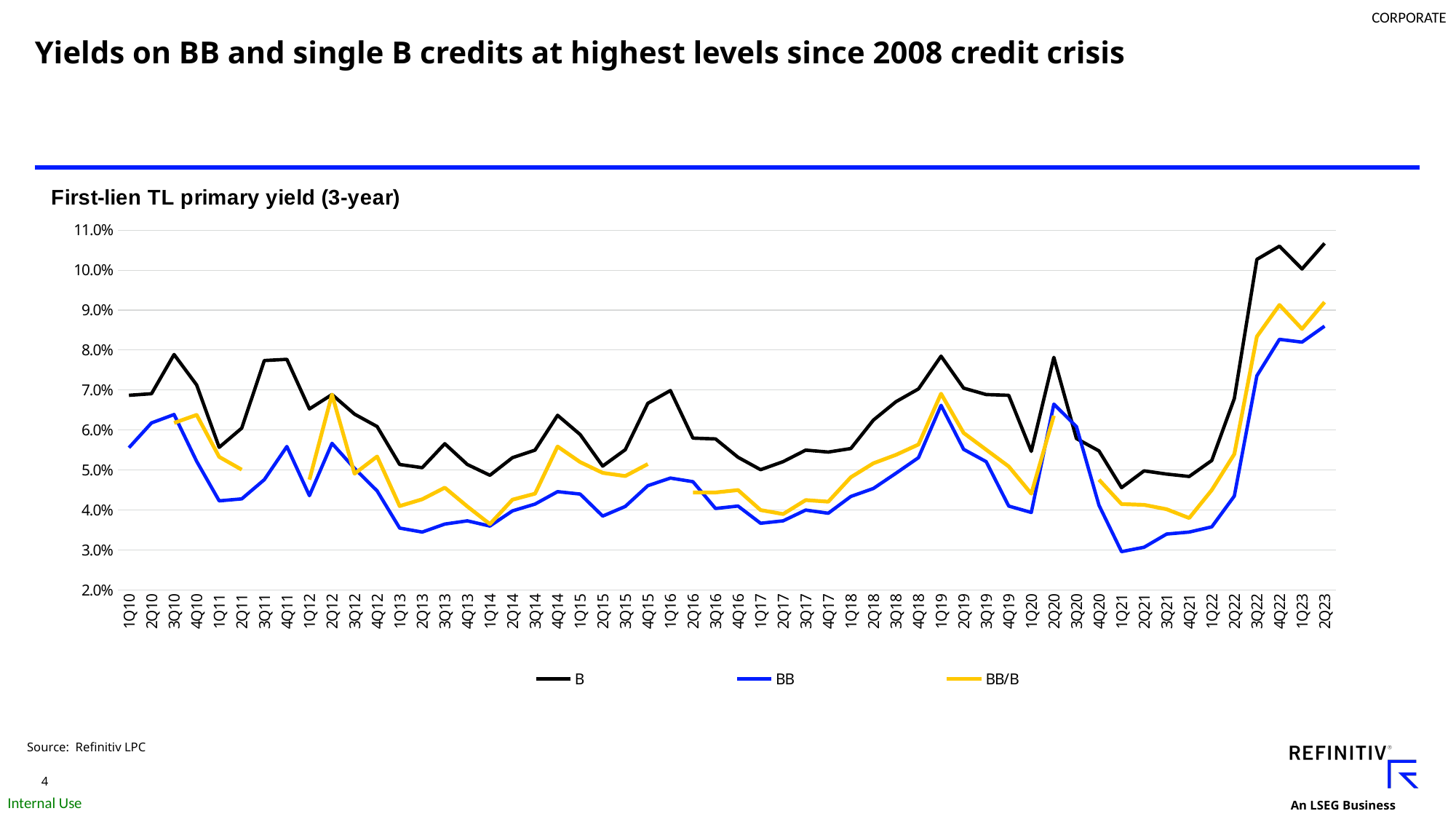
Is the value for BB at 3Q10 greater or less than 6.0%? greater What kind of chart is shown on the slide? line chart Is the value for BB at 1Q21 greater or less than 4.0%? less Which series reaches the highest value on the chart? B Which series are listed in the chart legend? B, BB, BB/B Is the value for B at 1Q14 greater or less than 6.0%? less Does the BB series rise or fall from 1Q21 to 2Q23? rise At 2Q23, which series has the larger value, B or BB? B What is the title of the chart? First-lien TL primary yield (3-year) How many series does the legend list? 3